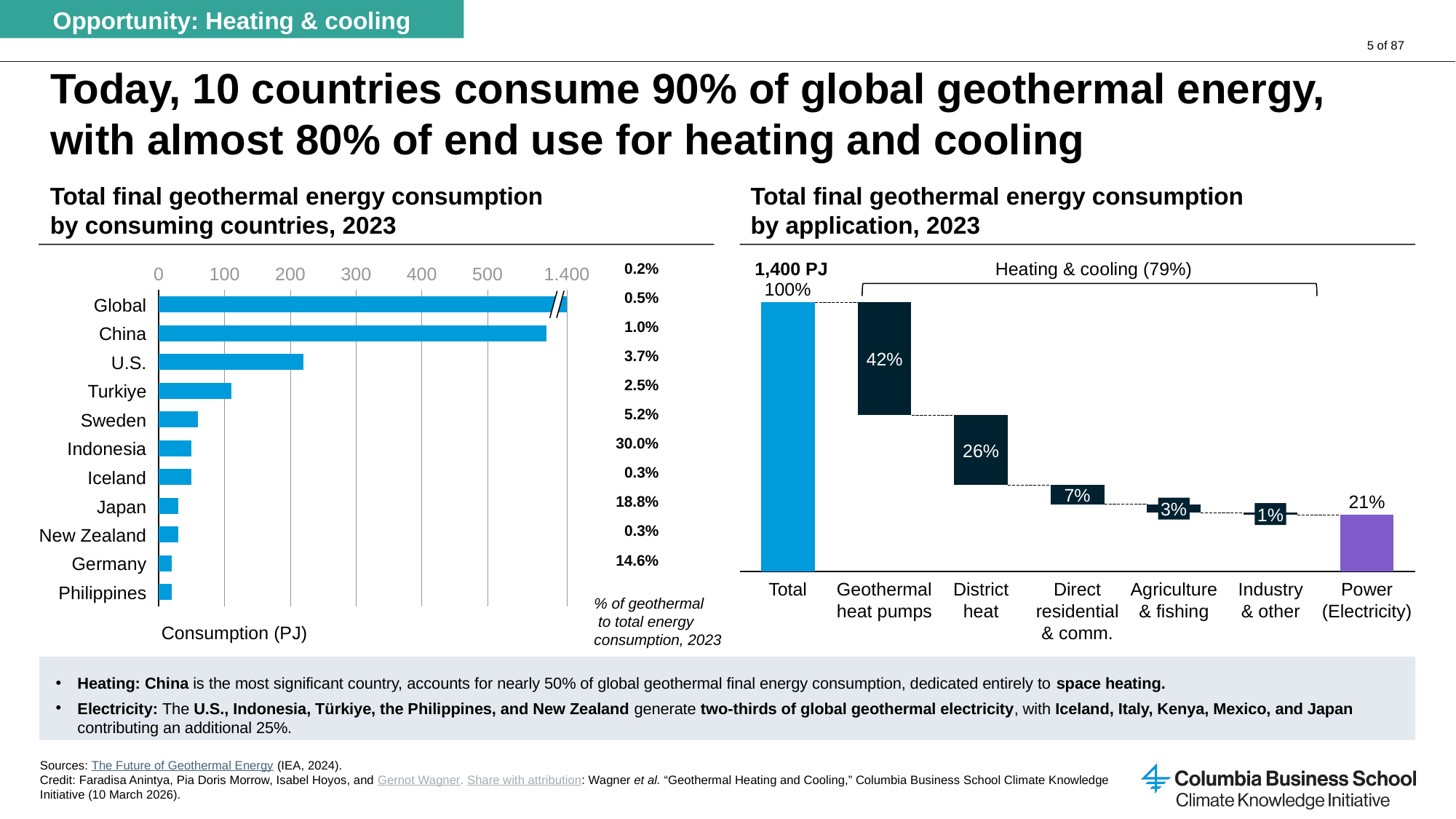
In the right chart (consumption by application), what share is labelled for Heating & cooling? 79% In the left chart (consumption by consuming countries), is the value for Sweden greater or less than 100? less In the right chart (consumption by application), which application has the lowest percentage? Industry & other In the right chart (consumption by application), what total consumption in PJ is labelled above the Total bar? 1,400 PJ In the right chart (consumption by application), what is the difference between the Geothermal heat pumps and District heat percentages? 16% In the left chart (consumption by consuming countries), is the value for the U.S. greater or less than 300? less In the right chart (consumption by application), what percentage is shown for Power (Electricity)? 21% In the left chart (consumption by consuming countries), how many bars are plotted? 11 In the right chart (consumption by application), what percentage is shown for Geothermal heat pumps? 42% What kind of chart is the 'Total final geothermal energy consumption by consuming countries, 2023' chart on the left? bar chart In the left chart (consumption by consuming countries), which has the larger consumption, the U.S. or Turkiye? U.S. In the left chart (consumption by consuming countries), which individual country has the highest consumption? China